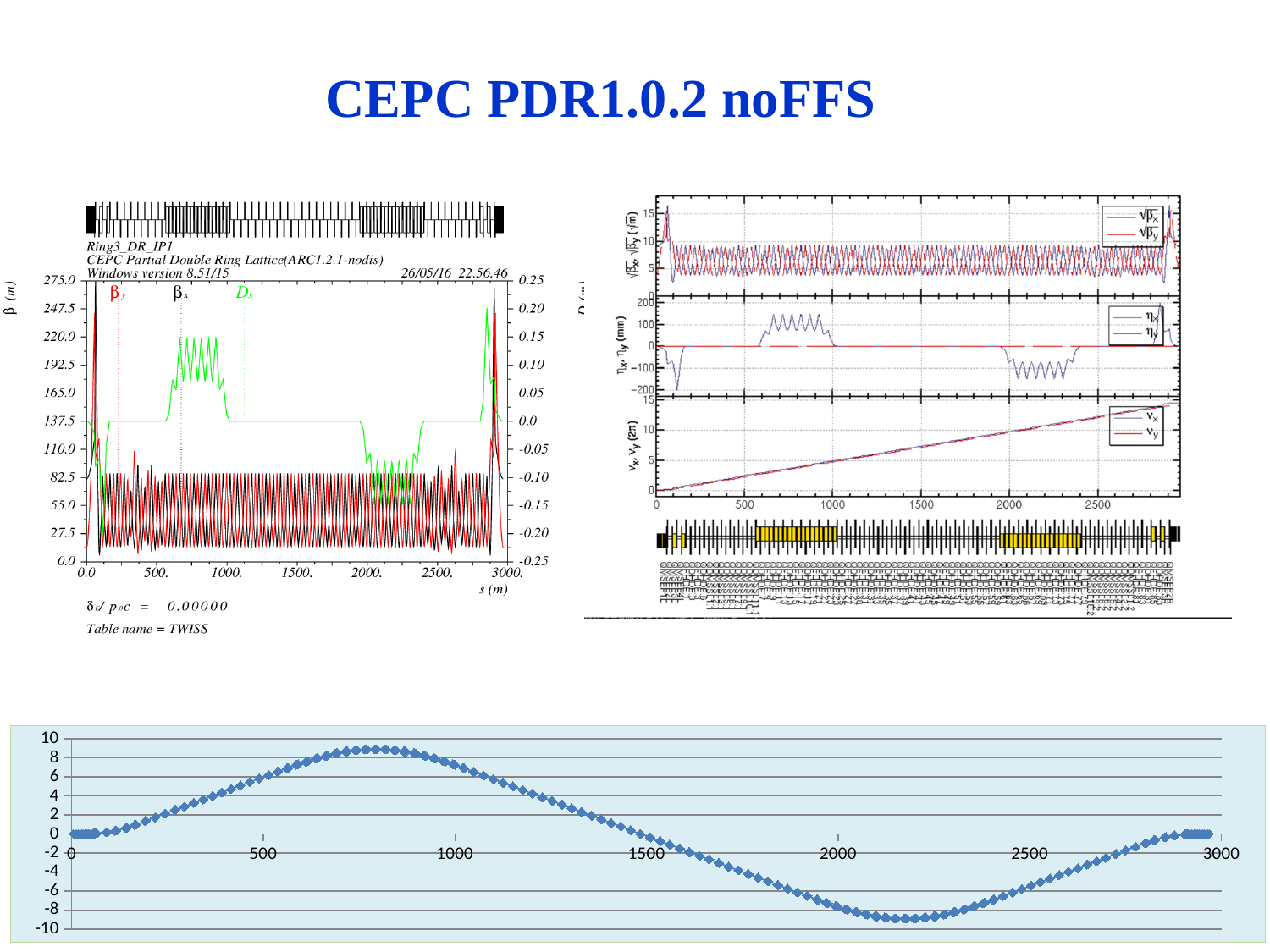
In the bottom chart, do the plotted values rise or fall as x goes from 1000 to 2000? fall In the top-right chart's bottom panel, do the νx and νy values rise or fall as s increases from 0 to 2500? rise In the top-right chart's middle panel, is the ηx value at s = 2200 greater or less than -50 mm? less In the top-left chart, what is the maximum value labelled on the left β (m) axis? 275.0 In the top-left chart, is the Dx value at s = 800 m greater or less than 0.10? greater In the bottom chart, what is the maximum value shown on the vertical axis? 10 In the top-left chart, is the Dx value at s = 2200 m greater or less than -0.05? less In the top-left chart, how many series are identified in the legend (βy, βx, Dx)? 3 In the bottom chart, do the plotted values rise or fall as x goes from 2300 to 2900? rise In the bottom chart, what is the largest value labelled on the horizontal axis? 3000